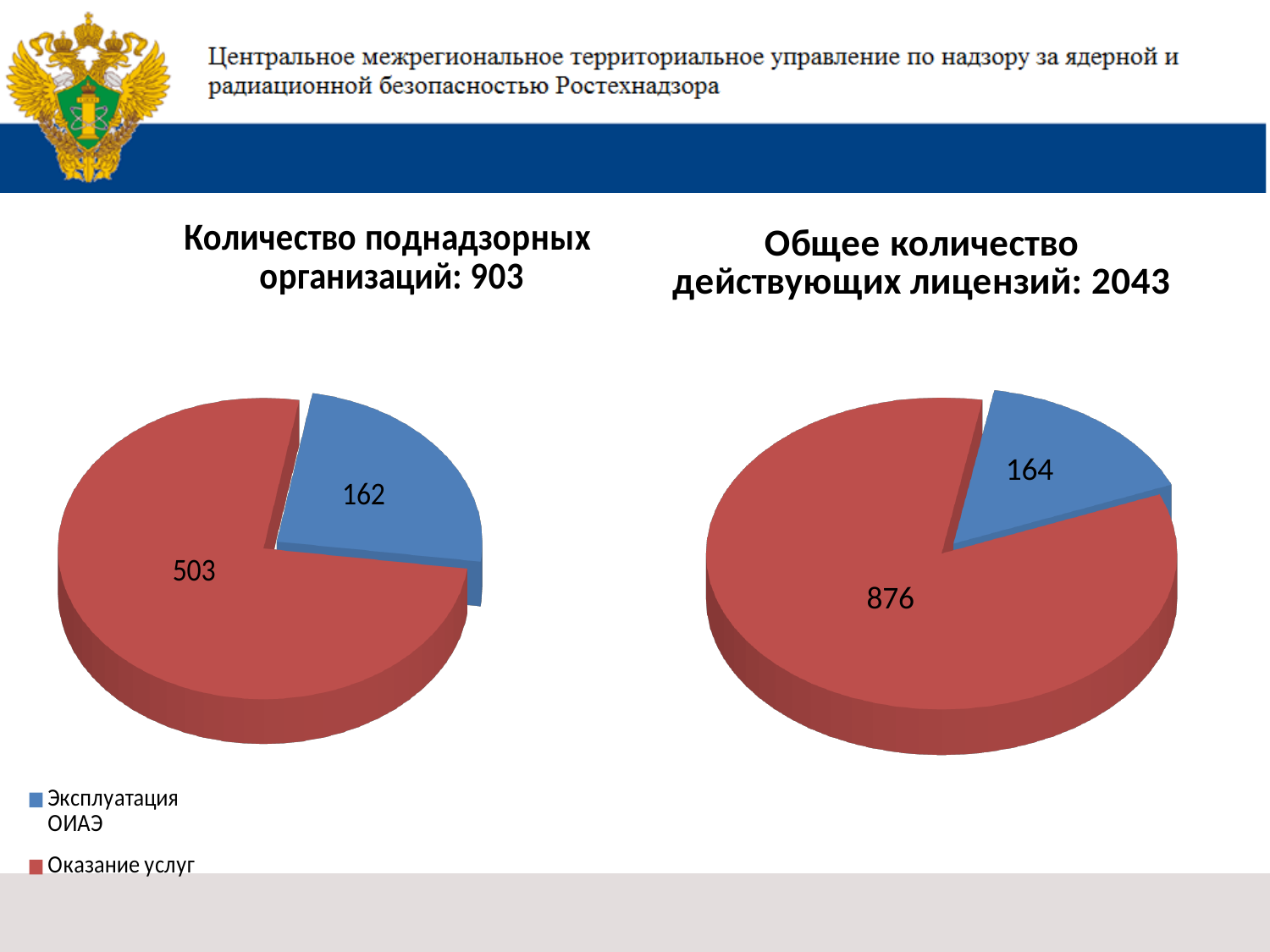
What type of chart is used on the left side of the slide? Pie chart How many slices does the right chart show? 2 In the right chart, which category has the smallest slice? Эксплуатация ОИАЭ In the chart titled "Общее количество действующих лицензий: 2043", what is the value of the blue slice? 164 In the left chart, what is the difference between the "Оказание услуг" value and the "Эксплуатация ОИАЭ" value? 341 In the chart titled "Количество поднадзорных организаций: 903", what is the value of the "Эксплуатация ОИАЭ" slice? 162 What colour is the "Оказание услуг" slice in the legend? Red In the left chart, which category has the largest slice? Оказание услуг In the chart titled "Общее количество действующих лицензий: 2043", what is the value of the red slice? 876 Which is larger: the "Эксплуатация ОИАЭ" value in the left chart or the "Эксплуатация ОИАЭ" value in the right chart? The right chart (164) In the right chart, what is the difference between the red slice value and the blue slice value? 712 In the chart titled "Количество поднадзорных организаций: 903", what is the value of the "Оказание услуг" slice? 503